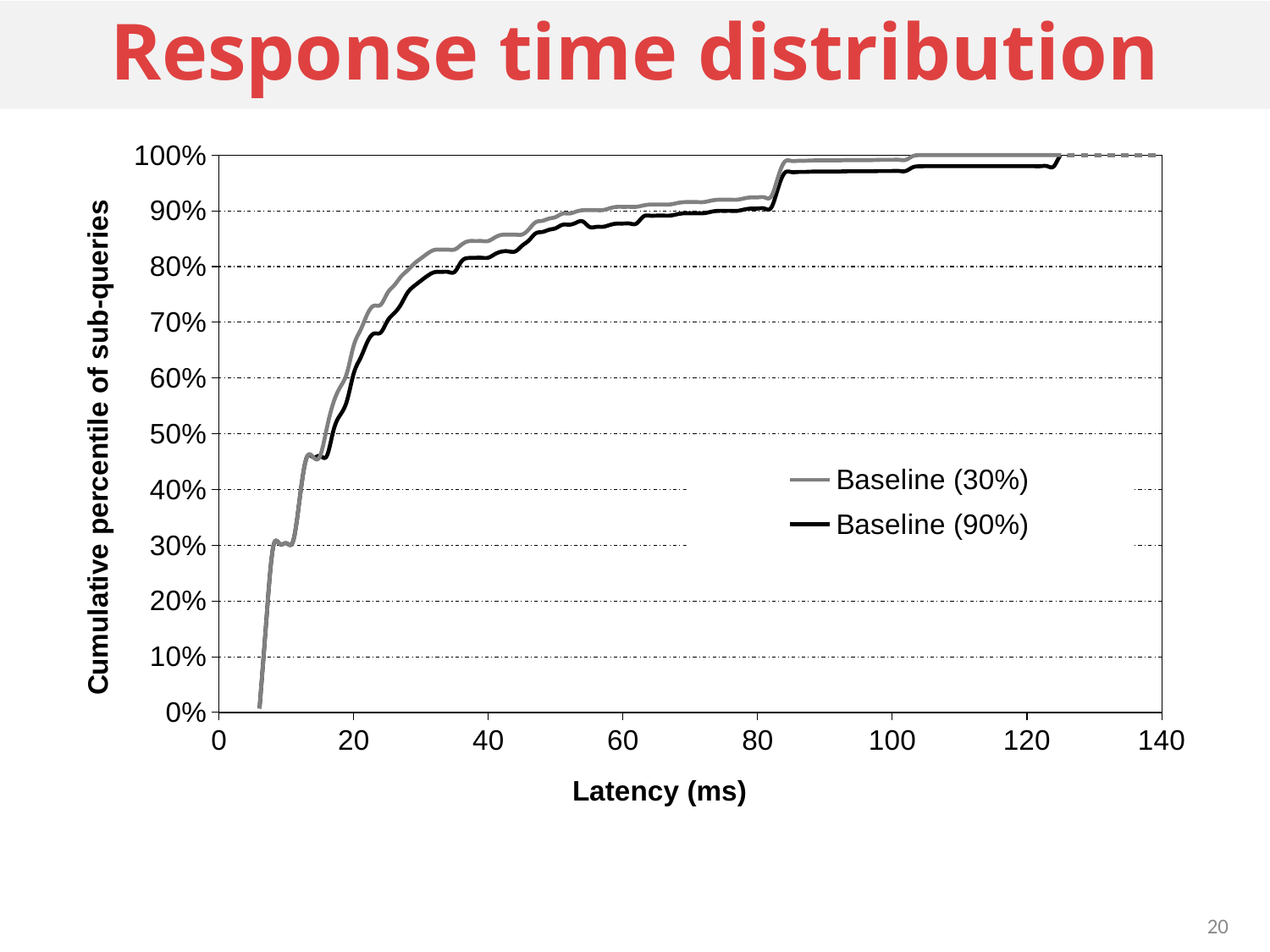
At a latency of 60 ms, is the value for Baseline (90%) greater or less than 90%? less How many series does the legend list? 2 What kind of chart is shown on the slide? line chart Do the values of the Baseline (30%) series rise or fall as latency increases? rise What is the title of the chart on the slide? Response time distribution Do the values of the Baseline (90%) series rise or fall as latency increases? rise At a latency of 40 ms, is the value for Baseline (30%) greater or less than 80%? greater At a latency of 20 ms, which series has the higher cumulative percentile, Baseline (30%) or Baseline (90%)? Baseline (30%) At a latency of 100 ms, is the value for Baseline (30%) greater or less than 90%? greater At a latency of 60 ms, which series has the higher cumulative percentile, Baseline (30%) or Baseline (90%)? Baseline (30%) What is the label of the x axis? Latency (ms)